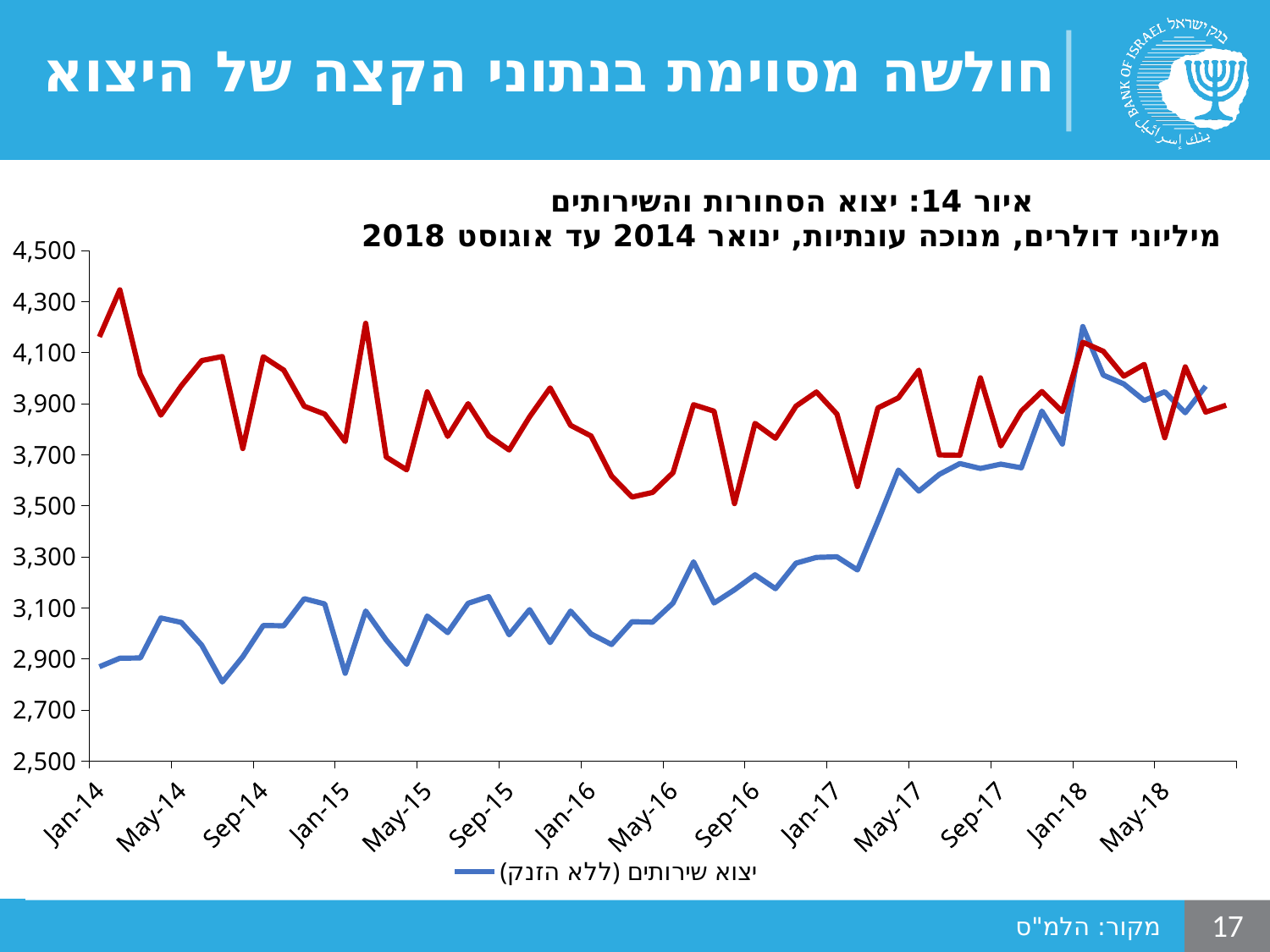
Is the value of the blue line (יצוא שירותים) at Jan-16 greater or less than 3,300? less Is the value of the blue line (יצוא שירותים) at Jan-14 greater or less than 3,100? less How many date labels are shown on the x axis? 14 Does the blue line (יצוא שירותים) generally rise or fall from Jan-14 to 2018? Rise What is the legend entry shown below the chart? יצוא שירותים (ללא הזנק) At Jan-14, which line has the higher value, the red line or the blue line? The red line Is the value of the red line at Jan-14 greater or less than 3,900? greater How many series does the chart's legend list? 1 What figure number is given in the chart title? 14 What kind of chart is shown on the slide? Line chart